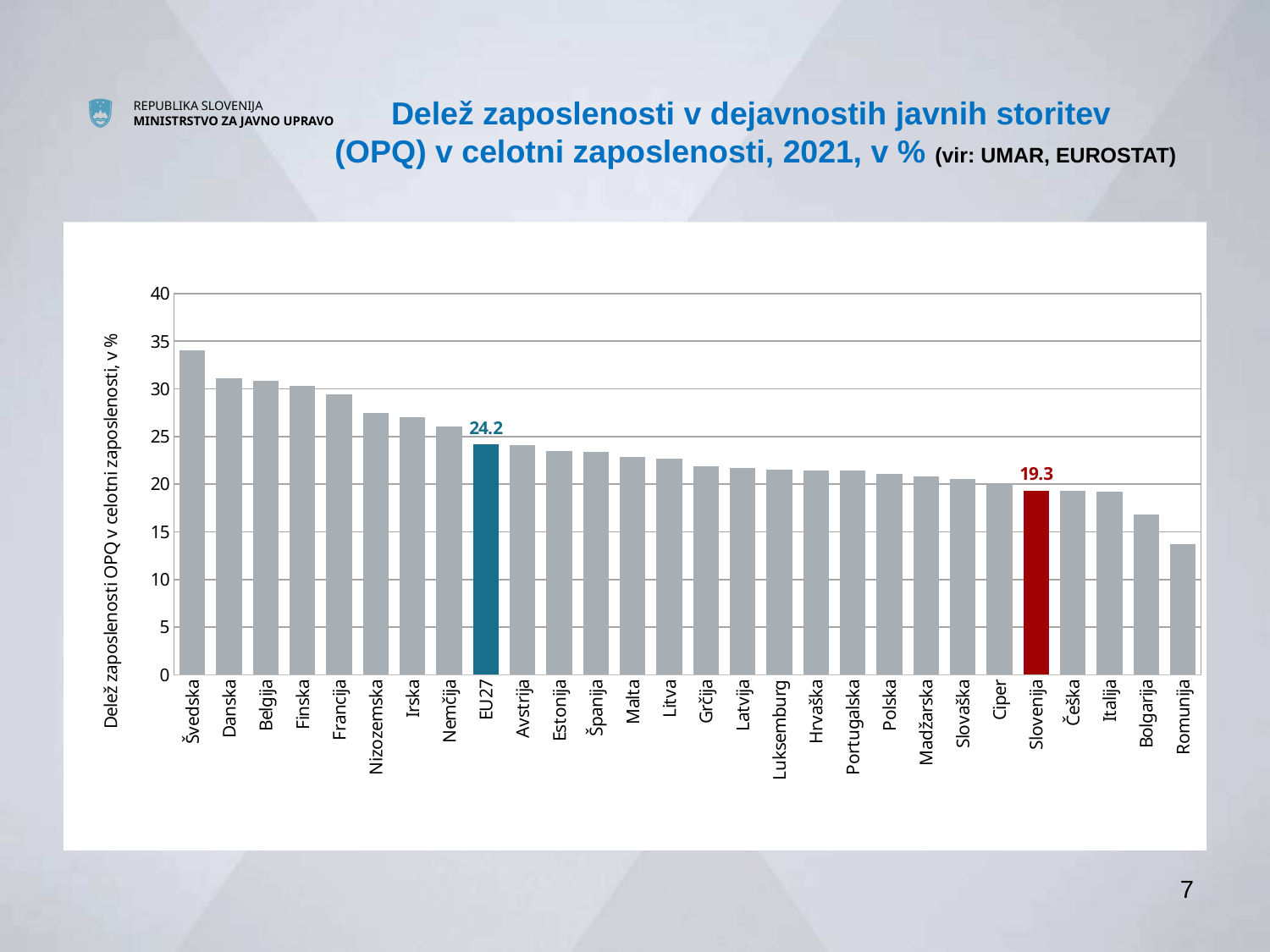
Is the value for Švedska greater or less than 30? greater Which country has the lowest share? Romunija How many bars are shown in the chart? 28 What is the value shown for Slovenija? 19.3 What is the difference between the EU27 value and the Slovenija value? 4.9 Is the value for Romunija greater or less than 15? less Which of EU27 or Slovenija has the larger value? EU27 What is the value shown for EU27? 24.2 What kind of chart is shown on the slide? Bar chart Do the values rise or fall from left to right along the x axis? Fall Which country has the highest share? Švedska Is the value for Francija greater or less than 25? greater